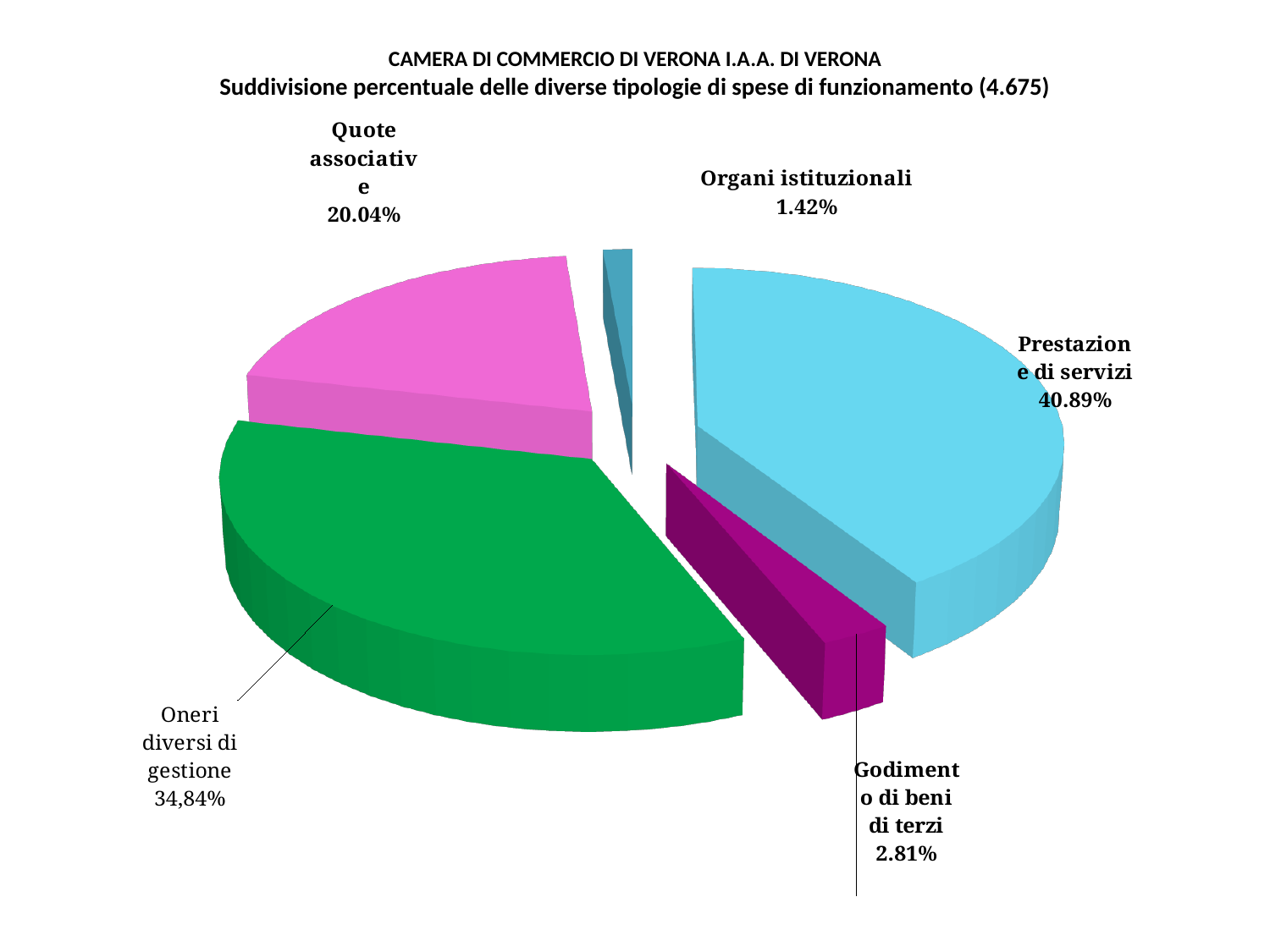
What percentage is shown for Prestazione di servizi? 40.89% What percentage is shown for Organi istituzionali? 1.42% Which is larger, the share for Quote associative or the share for Godimento di beni di terzi? Quote associative Which category has the largest share of the pie? Prestazione di servizi What percentage is shown for Quote associative? 20.04% What colour is the slice for Prestazione di servizi? Light blue What percentage is shown for Godimento di beni di terzi? 2.81% Which category has the smallest share of the pie? Organi istituzionali What kind of chart is shown on the slide? Pie chart What percentage is shown for Oneri diversi di gestione? 34,84% What is the difference in percentage points between Prestazione di servizi and Quote associative? 20.85 How many categories are shown in the pie chart? 5